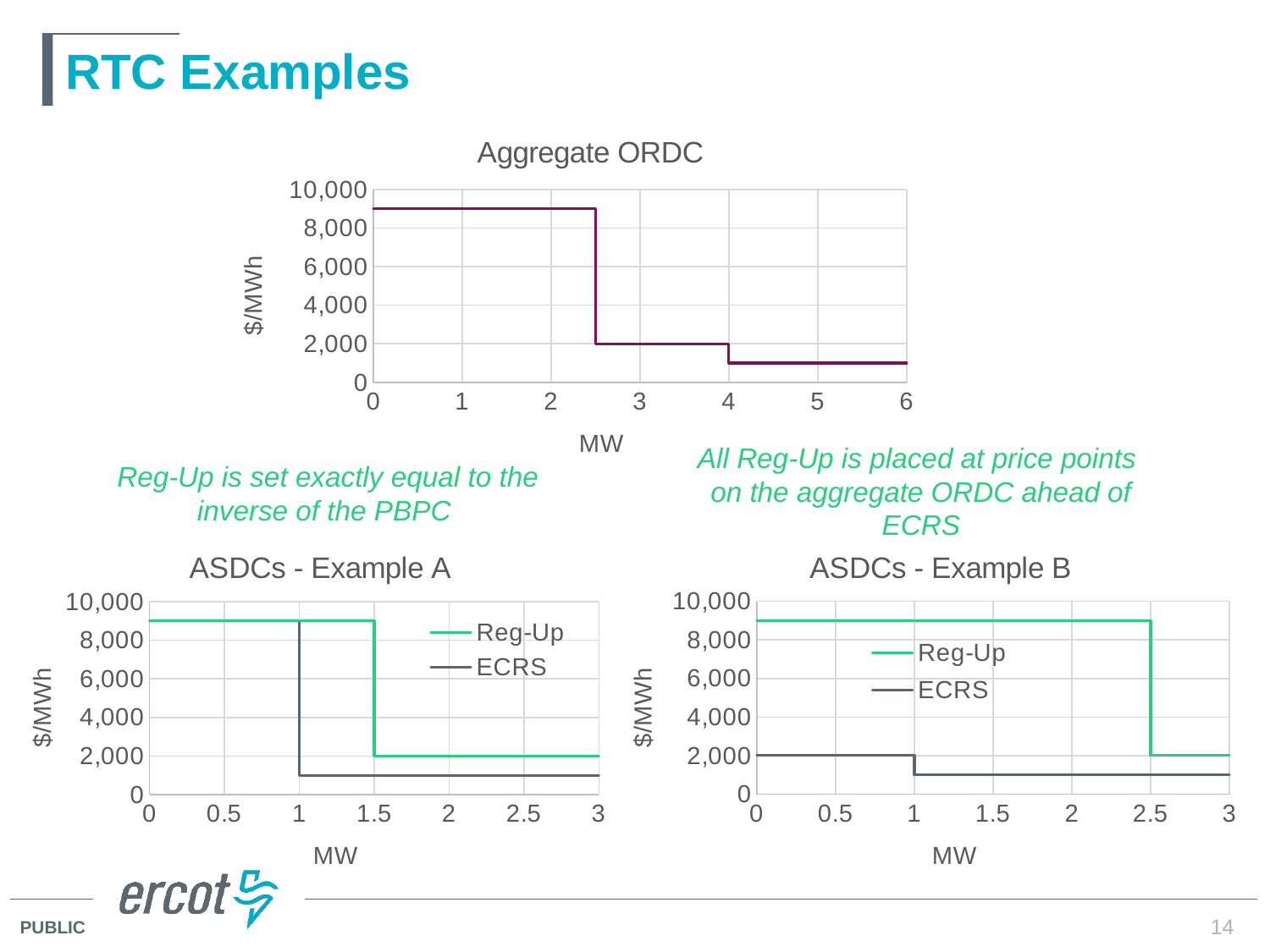
In the ASDCs - Example A chart, at what MW value does the Reg-Up line step down from its initial level? 1.5 How many series does the legend of the ASDCs - Example A chart list? 2 In the ASDCs - Example A chart, what is the Reg-Up value in $/MWh at 2 MW? 2,000 In the Aggregate ORDC chart, is the value at 1 MW greater or less than 8,000? greater In the Aggregate ORDC chart, is the value at 5 MW greater or less than 2,000? less In the Aggregate ORDC chart, do the values rise or fall as MW increases? fall In the ASDCs - Example A chart, which series has the larger value at 2 MW, Reg-Up or ECRS? Reg-Up What are the legend entries in the ASDCs - Example B chart? Reg-Up, ECRS In the Aggregate ORDC chart, what is the value in $/MWh at 3 MW? 2,000 In the ASDCs - Example B chart, is the Reg-Up value at 2 MW greater or less than 8,000? greater What kind of chart is the Aggregate ORDC chart? line chart In the ASDCs - Example B chart, what is the ECRS value in $/MWh at 0.5 MW? 2,000